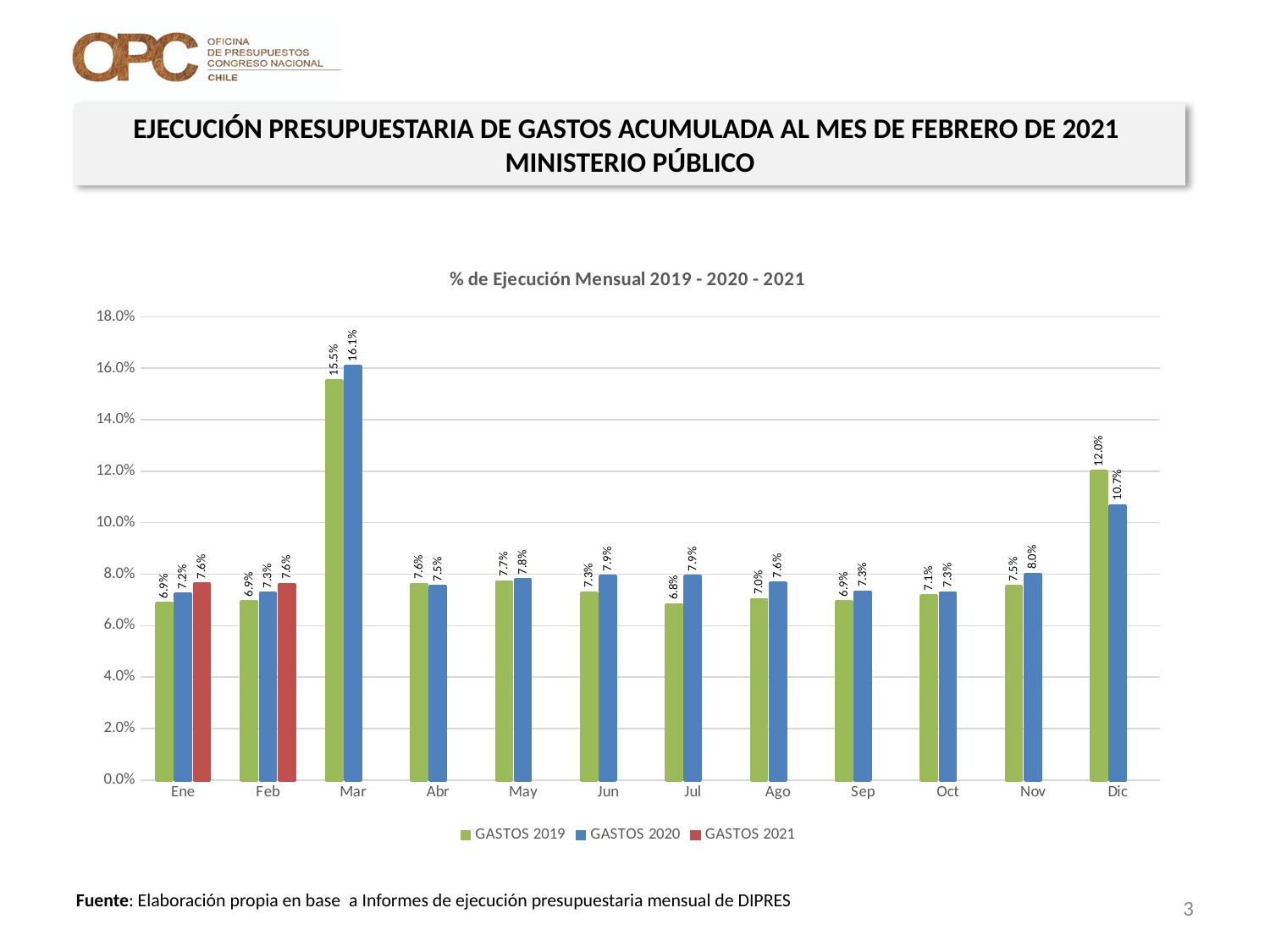
What is the value for GASTOS 2021 in Feb? 7.6% What is the difference between GASTOS 2020 and GASTOS 2019 in Mar? 0.6 percentage points What is the difference between GASTOS 2019 and GASTOS 2020 in Dic? 1.3 percentage points What is the value for GASTOS 2020 in Mar? 16.1% Which month has the lowest value for GASTOS 2019? Jul Is the value for GASTOS 2020 in Mar greater or less than 14.0%? greater What is the value for GASTOS 2019 in Dic? 12.0% What kind of chart is shown on the slide? Bar chart Which month has the highest value for GASTOS 2019? Mar In Dic, which is larger, GASTOS 2019 or GASTOS 2020? GASTOS 2019 How many series does the legend list? 3 How many months are shown on the x axis? 12